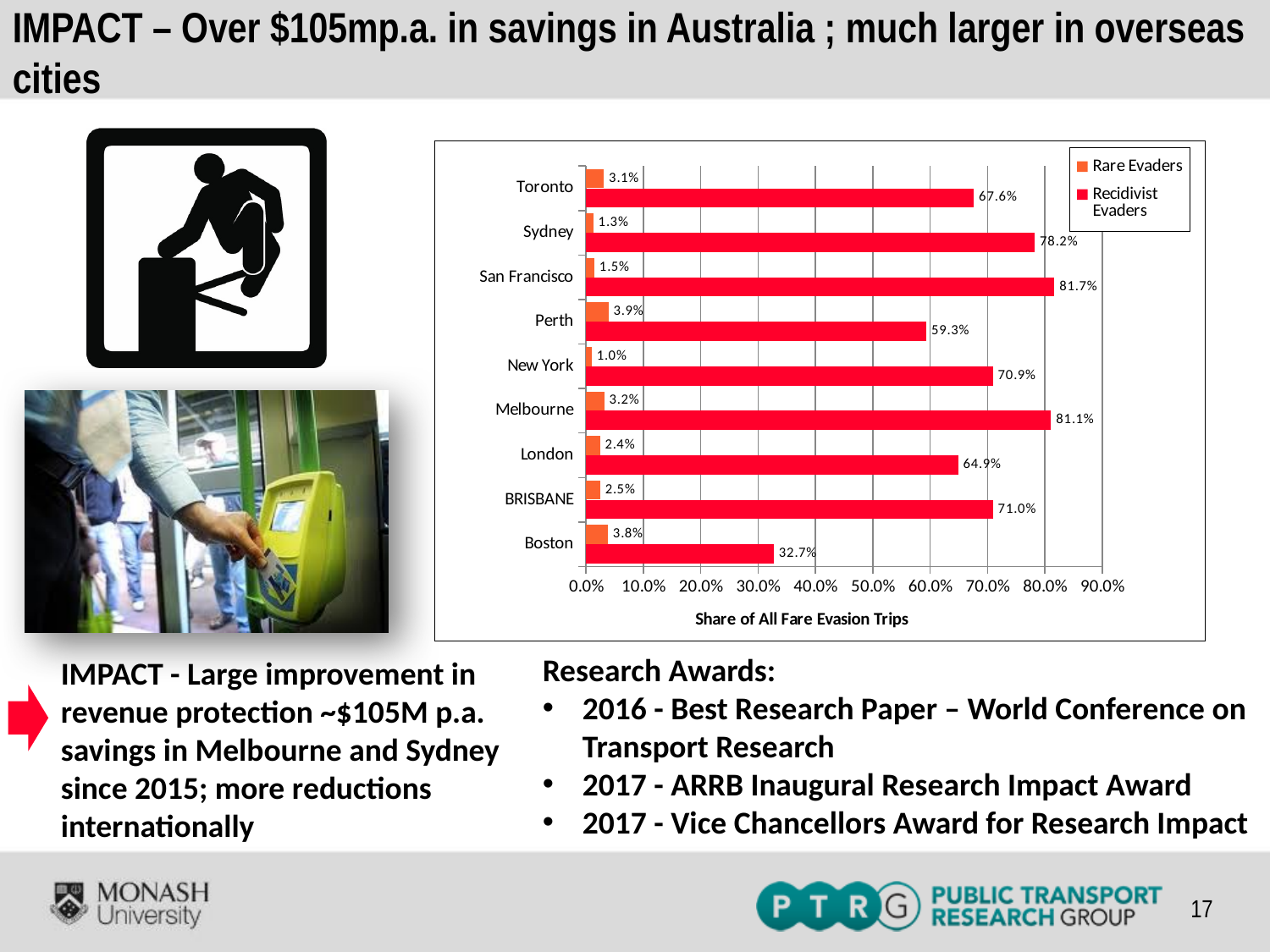
Which city has the highest Recidivist Evaders value? San Francisco Which city has the lowest Recidivist Evaders value? Boston How many cities are shown on the chart? 9 Which is larger, the Recidivist Evaders value for London or for BRISBANE? BRISBANE What kind of chart is shown on the slide? Bar chart What is the Recidivist Evaders value for Melbourne? 81.1% What is the Recidivist Evaders value for Boston? 32.7% Which city has the lowest Rare Evaders value? New York What is the Rare Evaders value for Perth? 3.9% How many series does the chart legend list? 2 What is the x-axis title of the chart? Share of All Fare Evasion Trips What is the difference between the Recidivist Evaders values for Sydney and Toronto? 10.6%